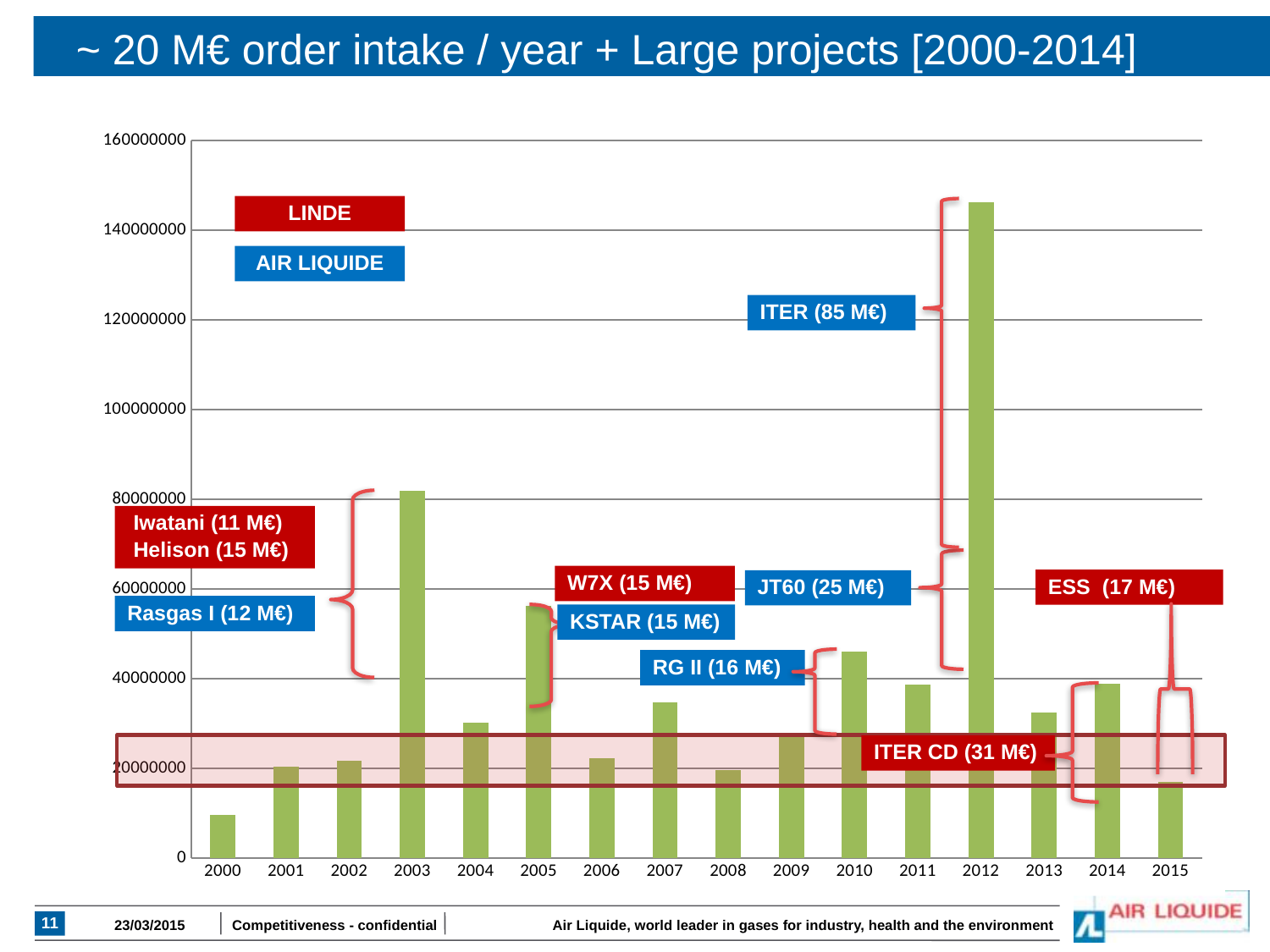
Which year has the larger bar, 2010 or 2011? 2010 Which year has the larger bar, 2003 or 2005? 2003 What amount is shown in the ITER label annotating the 2012 bar? 85 M€ Which year has the lowest order intake bar? 2000 Is the value for 2000 greater or less than 20000000? less Is the value for 2012 greater or less than 140000000? greater How many years (bars) are plotted on the x axis? 16 What kind of chart is shown on the slide? bar chart Is the value for 2003 greater or less than 60000000? greater Which year has the highest order intake bar? 2012 What is the title of the slide? ~ 20 M€ order intake / year + Large projects [2000-2014]